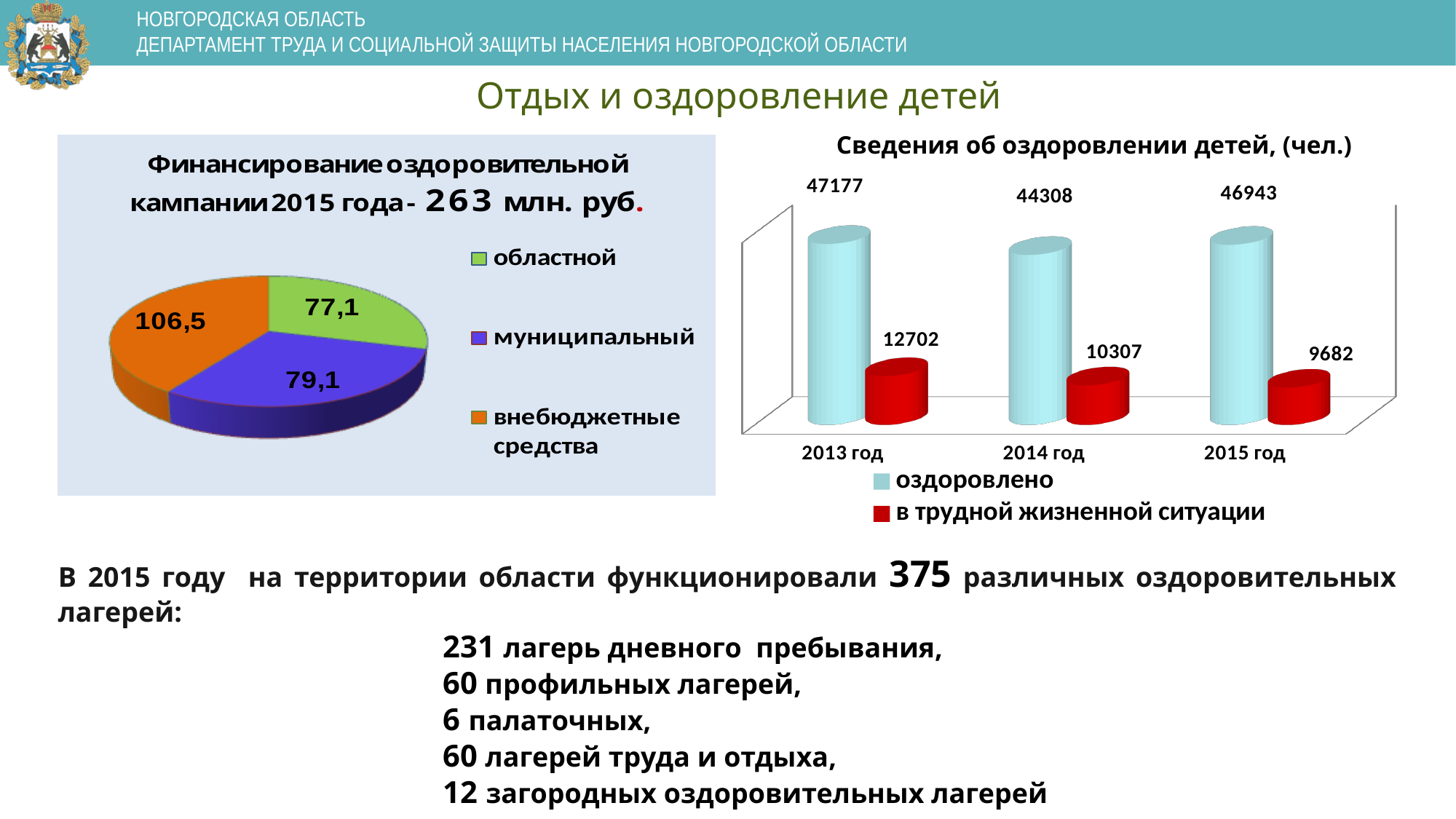
In the chart 'Сведения об оздоровлении детей, (чел.)', does the 'в трудной жизненной ситуации' series rise or fall from 2013 год to 2015 год? fall In the chart 'Сведения об оздоровлении детей, (чел.)', which year has the highest 'оздоровлено' value? 2013 год In the pie chart on the left, how many slices are there? 3 In the pie chart on the left, what is the value for the 'областной' slice? 77,1 In the pie chart on the left, which slice is the largest? внебюджетные средства In the chart 'Сведения об оздоровлении детей, (чел.)', what is the value for 'оздоровлено' in 2014 год? 44308 In the pie chart on the left, what is the difference between the 'внебюджетные средства' and 'областной' values? 29,4 In the chart 'Сведения об оздоровлении детей, (чел.)', how many series does the legend list? 2 In the pie chart on the left, what is the value for the 'внебюджетные средства' slice? 106,5 In the chart 'Сведения об оздоровлении детей, (чел.)', what is the value for 'в трудной жизненной ситуации' in 2015 год? 9682 In the chart 'Сведения об оздоровлении детей, (чел.)', what is the difference between the 'в трудной жизненной ситуации' values for 2013 год and 2015 год? 3020 In the chart 'Сведения об оздоровлении детей, (чел.)', which year has the lowest 'в трудной жизненной ситуации' value? 2015 год